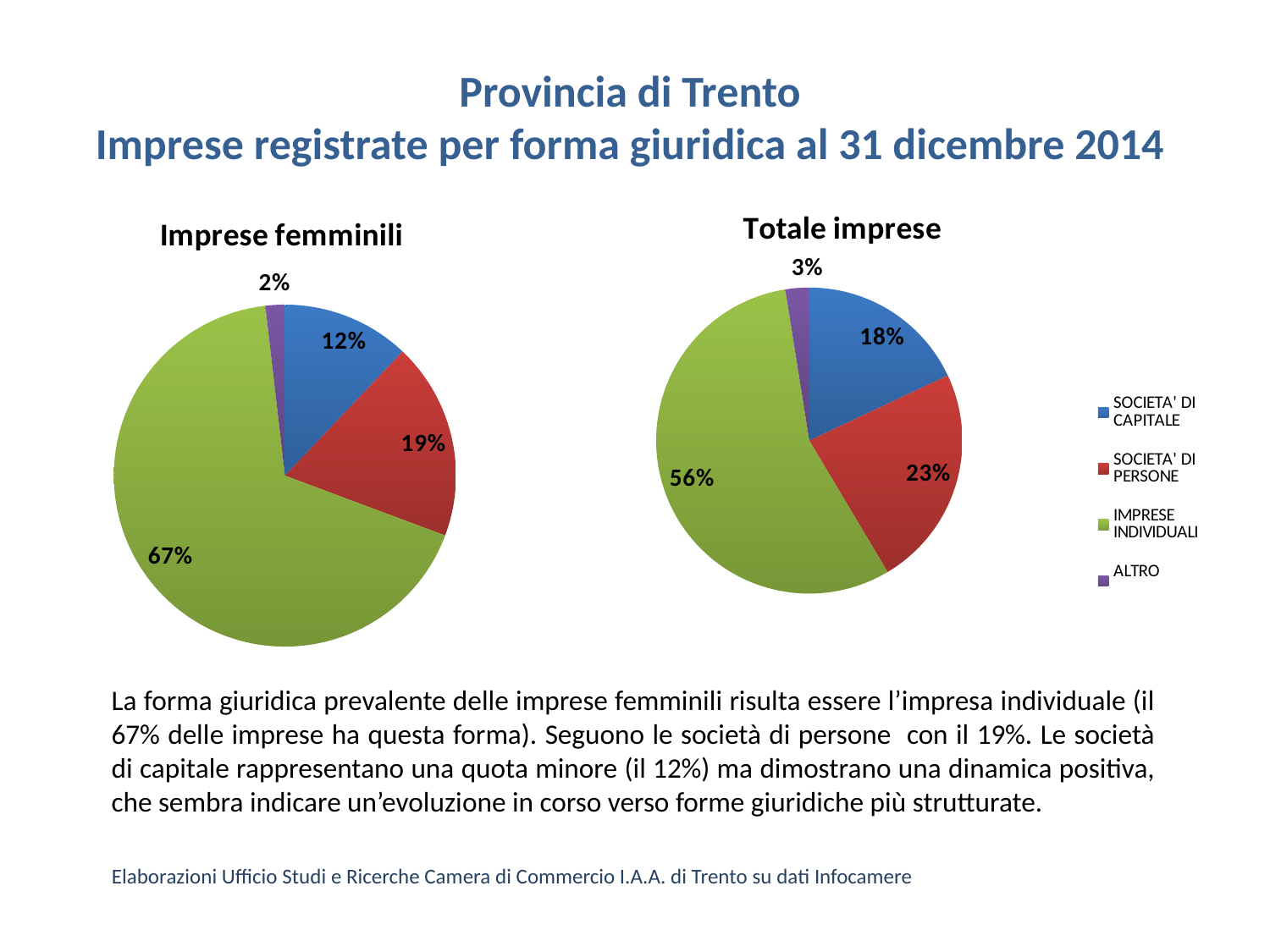
In the "Imprese femminili" chart, what is the value for SOCIETA' DI PERSONE? 19% In the "Totale imprese" chart, which is larger: SOCIETA' DI PERSONE or SOCIETA' DI CAPITALE? SOCIETA' DI PERSONE How many categories does the "Imprese femminili" chart show? 4 In the "Totale imprese" chart, what share do SOCIETA' DI CAPITALE have? 18% What type of chart is the "Totale imprese" chart? Pie chart In the "Imprese femminili" chart, what share do IMPRESE INDIVIDUALI have? 67% In the "Imprese femminili" chart, what is the difference between the SOCIETA' DI PERSONE and SOCIETA' DI CAPITALE shares? 7 percentage points Which colour represents IMPRESE INDIVIDUALI in the legend? Green In the "Totale imprese" chart, what is the value for ALTRO? 3% In the "Imprese femminili" chart, which category has the largest slice? IMPRESE INDIVIDUALI What is the difference between the IMPRESE INDIVIDUALI share in the "Imprese femminili" chart and in the "Totale imprese" chart? 11 percentage points In the "Totale imprese" chart, which category has the smallest slice? ALTRO